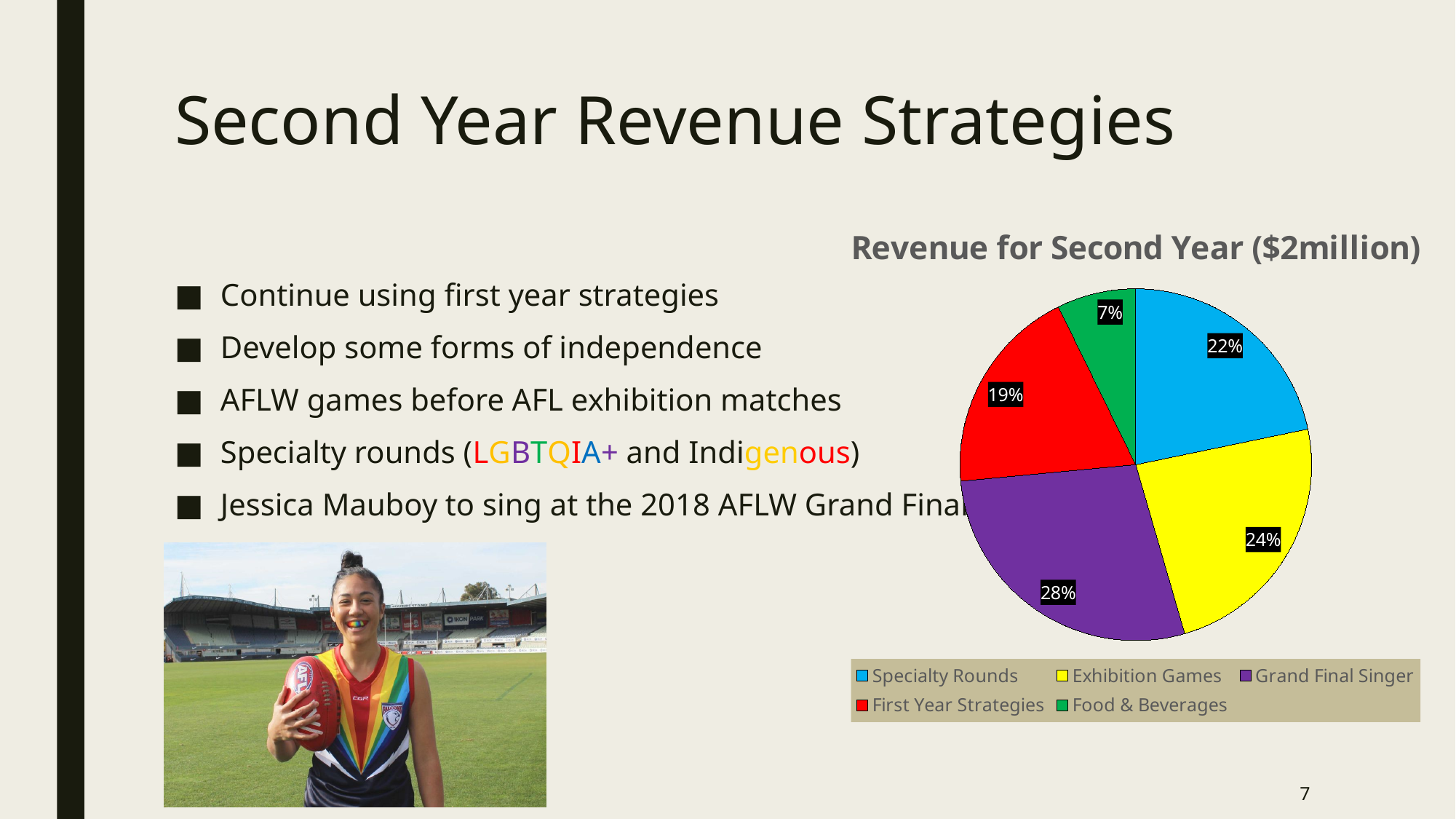
Which has a larger share, Exhibition Games or First Year Strategies? Exhibition Games What share of revenue comes from Exhibition Games? 24% What share of revenue comes from Specialty Rounds? 22% How many categories does the legend list? 5 What share of revenue comes from the Grand Final Singer? 28% Which category has the largest share of the pie? Grand Final Singer Which category has the smallest share of the pie? Food & Beverages What is the difference in percentage points between Grand Final Singer and Food & Beverages? 21 What share of revenue comes from Food & Beverages? 7% What type of chart is shown on the slide? Pie chart What is the title of the chart? Revenue for Second Year ($2million) What share of revenue comes from First Year Strategies? 19%